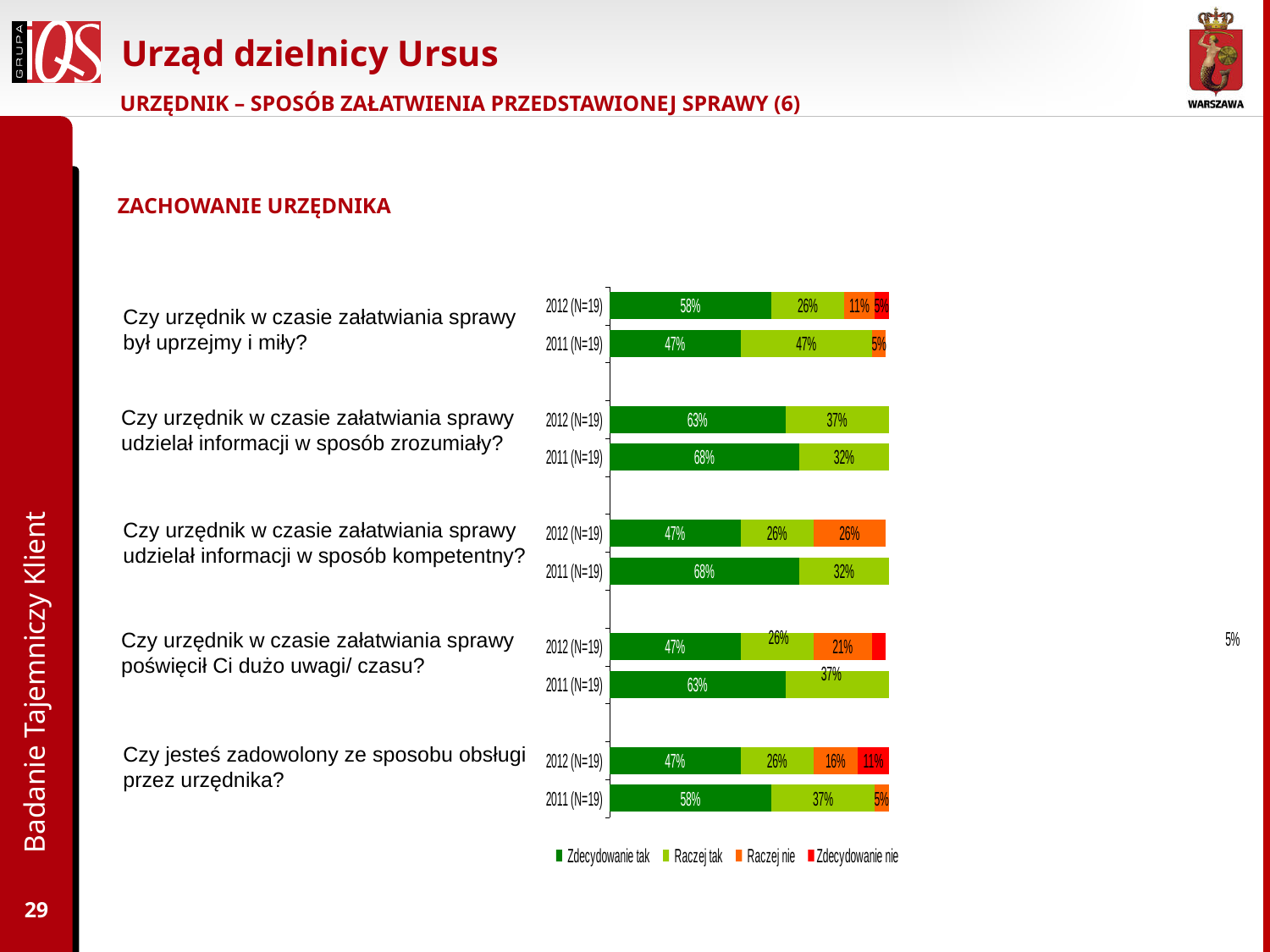
What is the total of the 'Zdecydowanie tak' and 'Raczej tak' segments for 2012 (N=19) for the question 'Czy jesteś zadowolony ze sposobu obsługi przez urzędnika?'? 73% How many series does the legend list? 4 What kind of chart is shown on the slide? stacked bar chart For the question 'Czy urzędnik w czasie załatwiania sprawy udzielał informacji w sposób kompetentny?', what is the difference between the 'Zdecydowanie tak' values for 2011 (N=19) and 2012 (N=19)? 21 percentage points What is the 'Zdecydowanie nie' value for 2012 (N=19) for the question 'Czy jesteś zadowolony ze sposobu obsługi przez urzędnika?'? 11% For the question 'Czy urzędnik w czasie załatwiania sprawy poświęcił Ci dużo uwagi/ czasu?', which year has the larger 'Zdecydowanie tak' value, 2012 (N=19) or 2011 (N=19)? 2011 (N=19) What is the 'Raczej tak' value for 2011 (N=19) for the question 'Czy urzędnik w czasie załatwiania sprawy udzielał informacji w sposób zrozumiały?'? 32% Which legend entry is shown in red? Zdecydowanie nie What is the 'Raczej nie' value for 2011 (N=19) for the question 'Czy jesteś zadowolony ze sposobu obsługi przez urzędnika?'? 5% Which row has the highest 'Zdecydowanie tak' value across the whole chart? 2011 (N=19) for 'udzielał informacji w sposób zrozumiały?' and 'udzielał informacji w sposób kompetentny?' (68%) What is the 'Raczej nie' value for 2012 (N=19) for the question 'Czy urzędnik w czasie załatwiania sprawy udzielał informacji w sposób kompetentny?'? 26% What is the 'Zdecydowanie tak' value for 2012 (N=19) for the question 'Czy urzędnik w czasie załatwiania sprawy był uprzejmy i miły?'? 58%